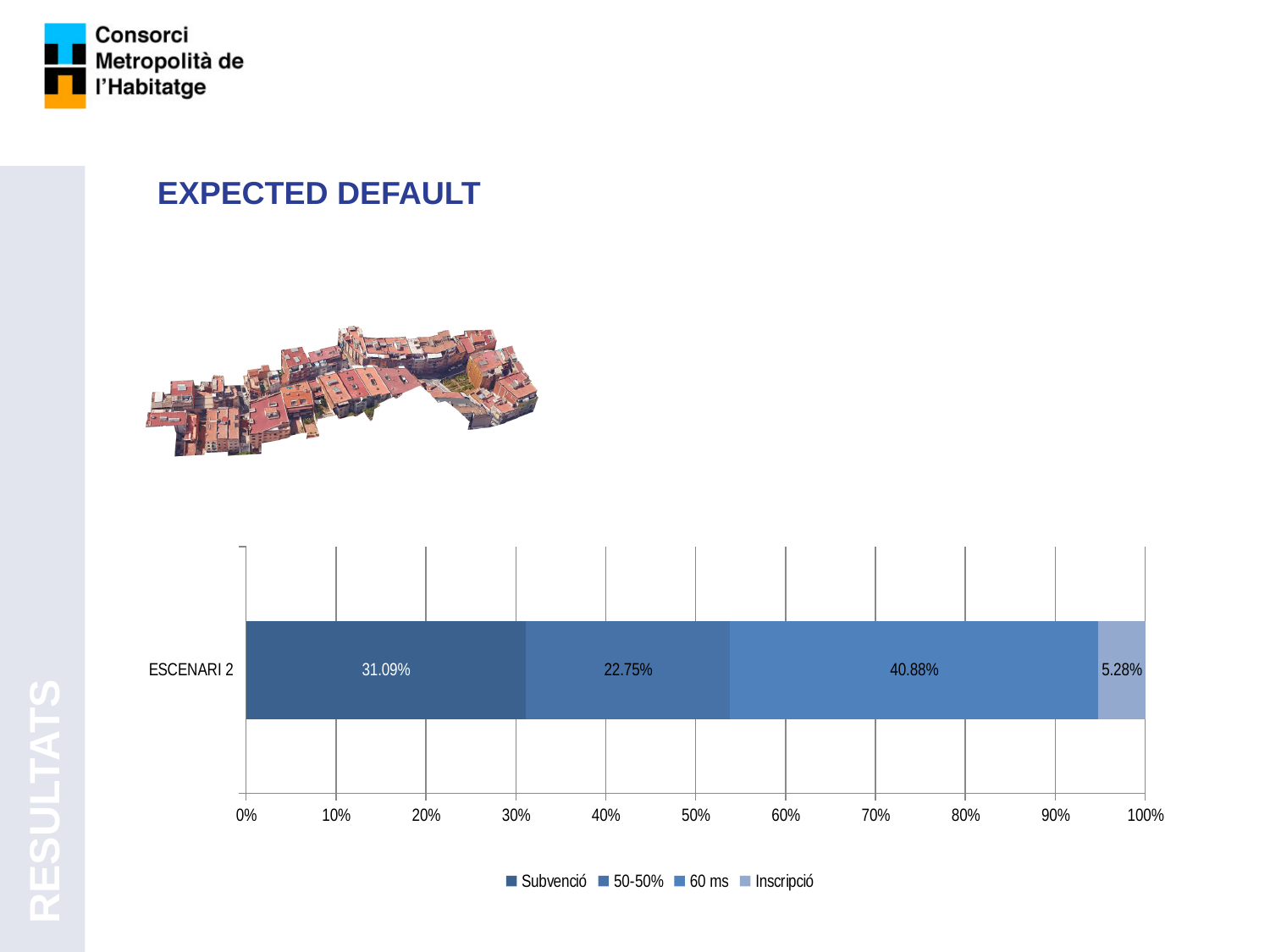
How many series does the legend list? 4 What is the value for 60 ms in ESCENARI 2? 40.88% What is the value for Subvenció in ESCENARI 2? 31.09% What is the value for Inscripció in ESCENARI 2? 5.28% Which series has the largest share of the ESCENARI 2 bar? 60 ms What is the difference between the 60 ms value and the Subvenció value in ESCENARI 2? 9.79% Which series has the smallest share of the ESCENARI 2 bar? Inscripció What is the value for 50-50% in ESCENARI 2? 22.75% What kind of chart is shown on the slide? Stacked bar chart Which is larger in ESCENARI 2, Subvenció or 50-50%? Subvenció How many categories are shown on the chart? 1 What is the total of the ESCENARI 2 stacked bar? 100.00%